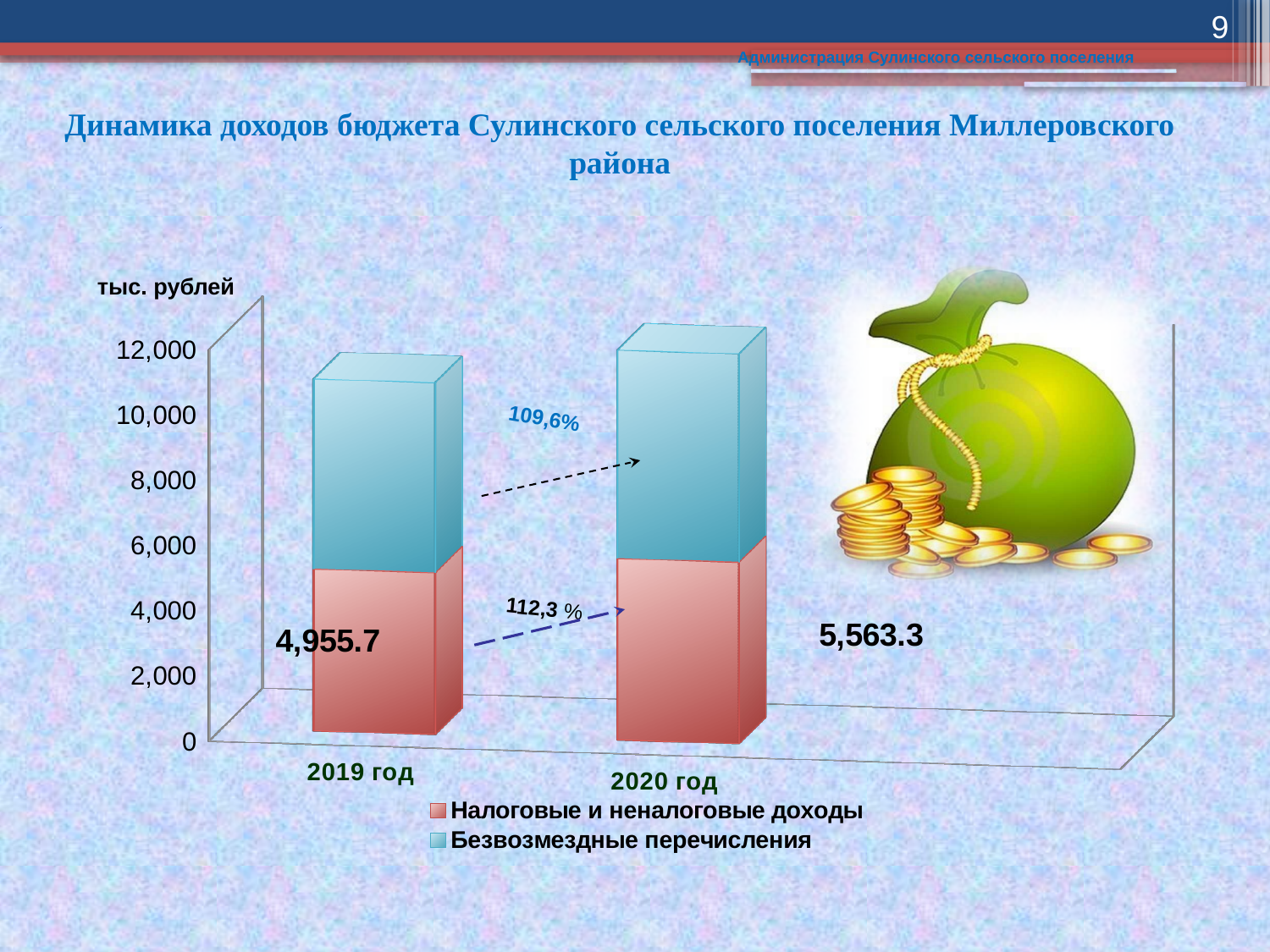
How many series does the legend list? 2 How many years (categories) are shown on the x axis? 2 What kind of chart is shown on the slide? stacked bar chart Which year has the larger value for Налоговые и неналоговые доходы, 2019 год or 2020 год? 2020 год Which series is shown in blue according to the legend? Безвозмездные перечисления Is the total stacked bar for 2019 год greater or less than 12,000? less What is the value of Налоговые и неналоговые доходы for 2020 год? 5,563.3 What is the value of Налоговые и неналоговые доходы for 2019 год? 4,955.7 Which year has the taller total stacked bar? 2020 год Do the values for Налоговые и неналоговые доходы rise or fall from 2019 год to 2020 год? rise By how much did Налоговые и неналоговые доходы change from 2019 год to 2020 год? 607.6 What unit is indicated above the vertical axis of the chart? тыс. рублей